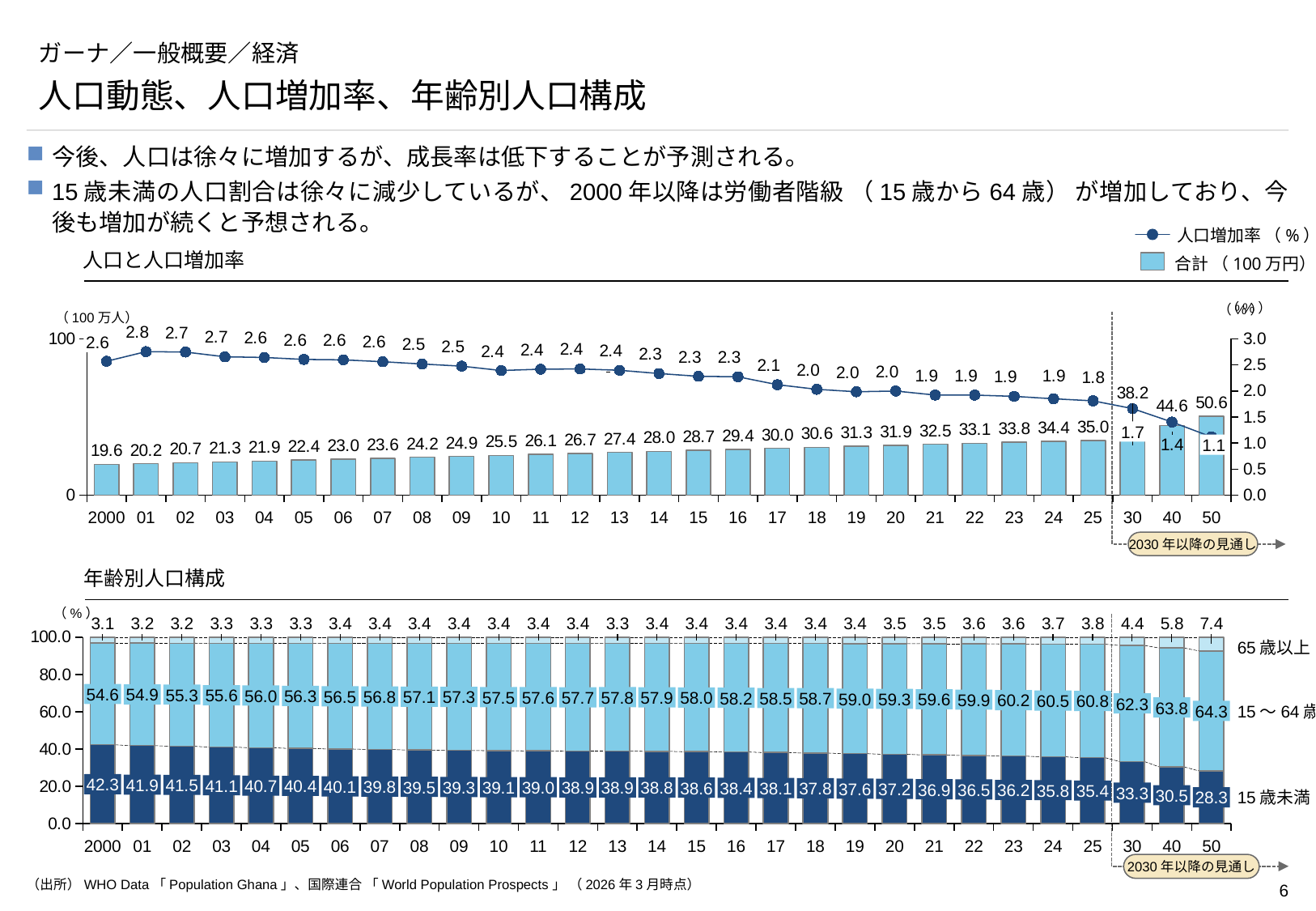
In the bottom chart (年齢別人口構成), how many age-group series are stacked in each bar? 3 In the top chart (人口と人口増加率), what is the population growth rate (人口増加率) shown for 2000? 2.6 In the top chart (人口と人口増加率), which year has the highest population growth rate? 01 In the bottom chart (年齢別人口構成), what is the value for 15歳未満 in 2000? 42.3 In the top chart (人口と人口増加率), how many years are shown on the x axis? 29 In the top chart (人口と人口増加率), what is the population value (合計) shown for 2010? 25.5 In the bottom chart (年齢別人口構成), is the 15～64歳 value larger in 2000 or in 25? 25 What kind of chart is the bottom chart (年齢別人口構成)? stacked bar chart In the top chart (人口と人口増加率), what is the difference between the population value for 50 and the population value for 2000? 31.0 In the bottom chart (年齢別人口構成), what is the value for 65歳以上 in 50? 7.4 In the top chart (人口と人口増加率), which year has the lowest population growth rate? 50 In the top chart (人口と人口増加率), does the population growth rate line generally rise or fall from 2000 to 50? fall